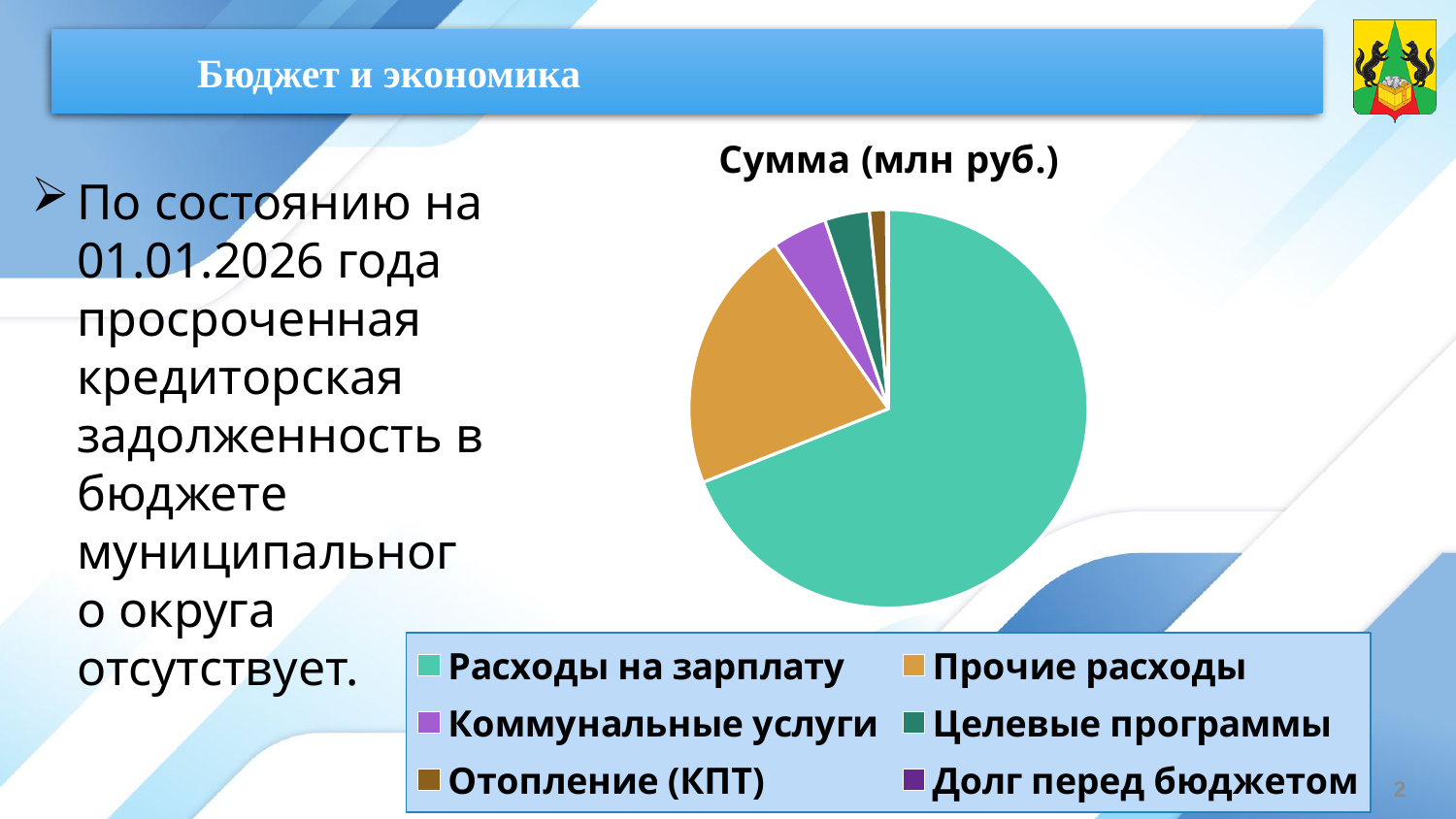
Which category has the second-largest slice of the pie chart? Прочие расходы What kind of chart is shown on the slide? pie chart What is the title of the pie chart? Сумма (млн руб.) Which is larger in the pie chart, Прочие расходы or Коммунальные услуги? Прочие расходы Which is larger in the pie chart, Расходы на зарплату or Целевые программы? Расходы на зарплату How many categories does the legend of the pie chart list? 6 Which category has the largest slice of the pie chart? Расходы на зарплату What colour represents Прочие расходы in the pie chart? orange Which is larger in the pie chart, Прочие расходы or Отопление (КПТ)? Прочие расходы